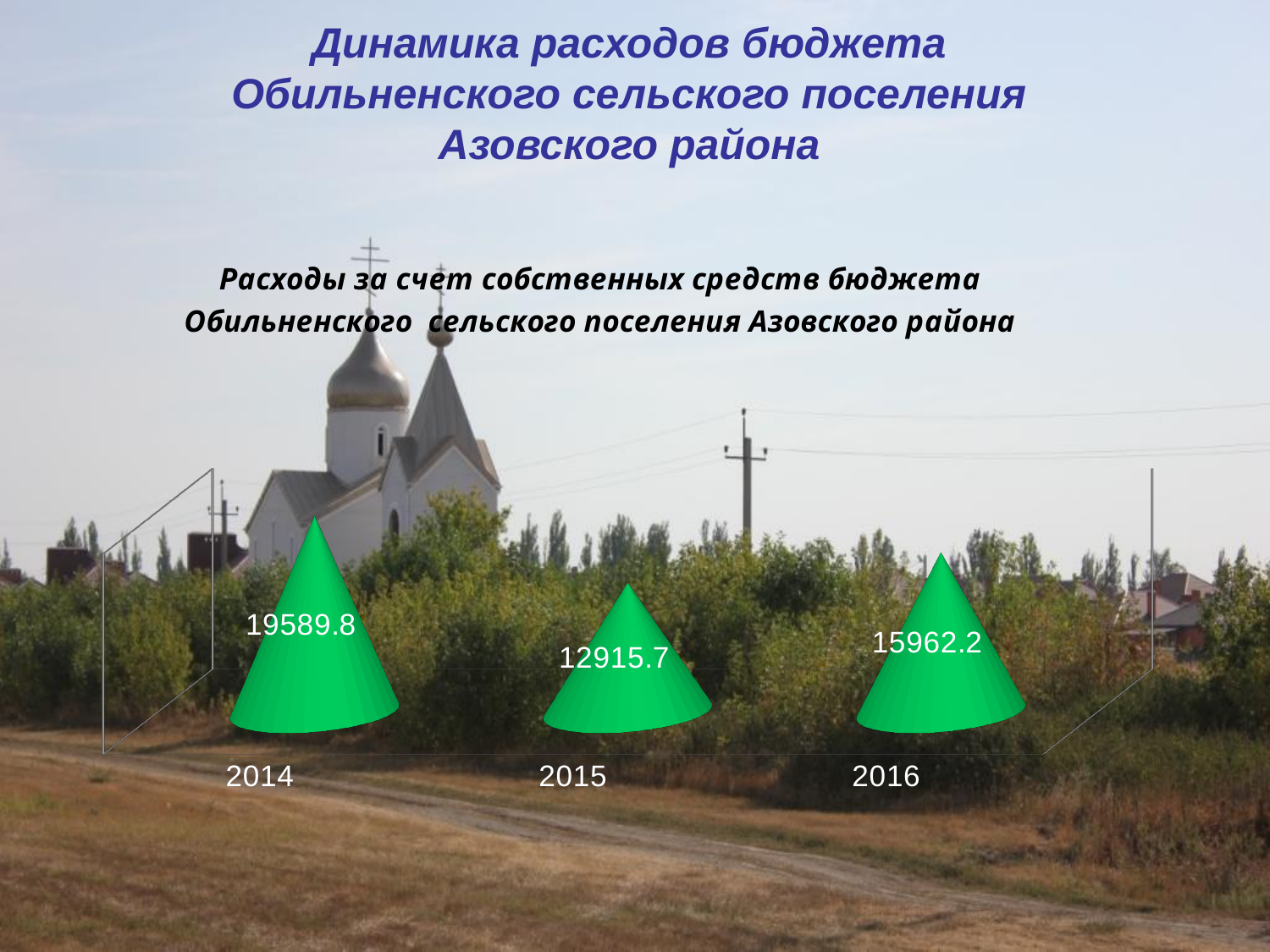
What is the value shown for 2014? 19589.8 What kind of chart is shown on the slide? bar chart Which is larger, the value for 2015 or the value for 2016? 2016 What is the value shown for 2016? 15962.2 Do the values rise or fall from 2014 to 2015? fall What is the difference between the values for 2014 and 2015? 6674.1 Which year has the lowest value? 2015 What is the value shown for 2015? 12915.7 What is the difference between the values for 2016 and 2015? 3046.5 What is the difference between the values for 2014 and 2016? 3627.6 How many years are shown on the chart? 3 Which year has the highest value? 2014